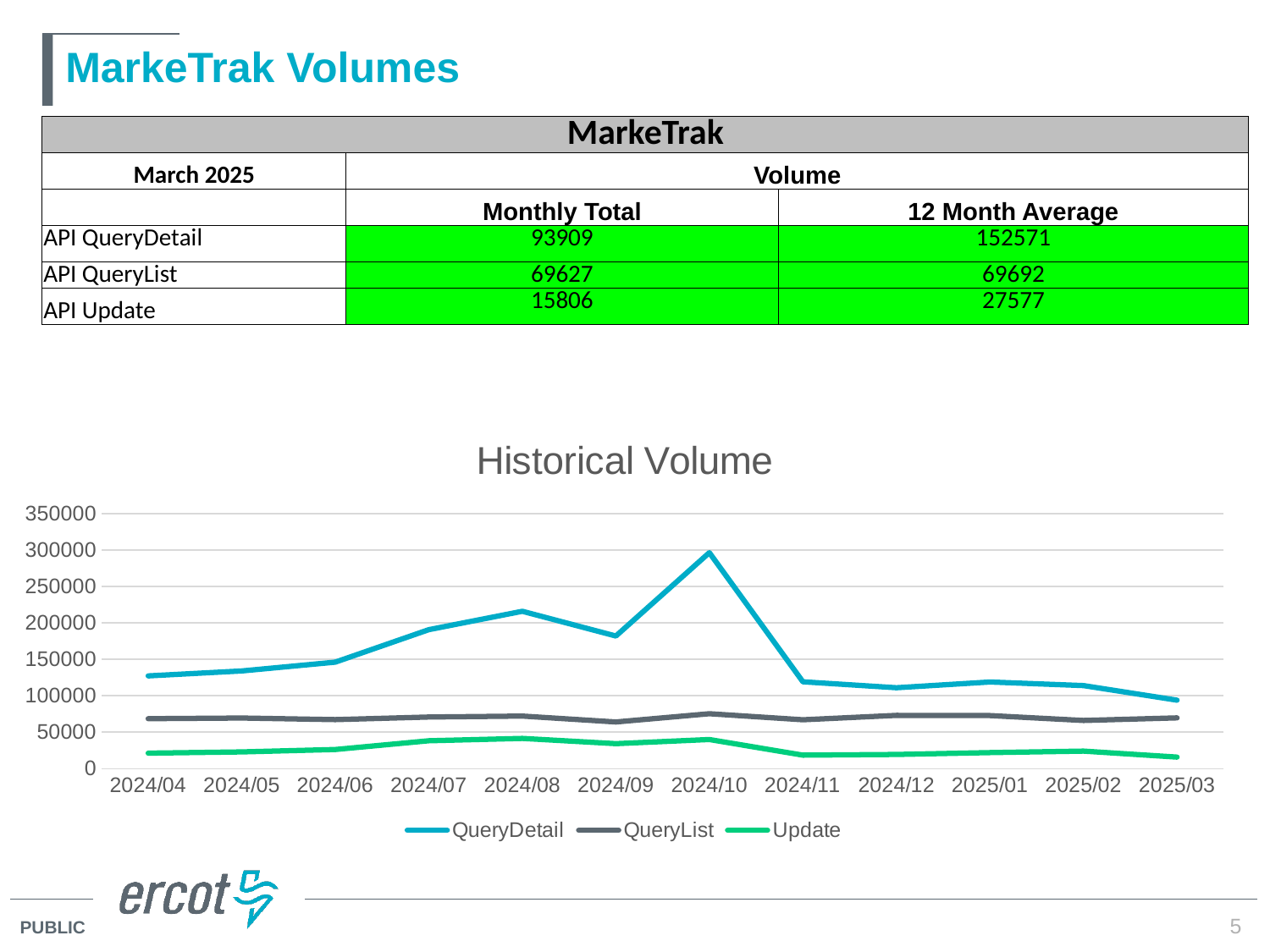
What is the title of the line chart on the slide? Historical Volume In the Historical Volume chart, which series has the larger value in 2024/10, QueryList or Update? QueryList In the Historical Volume chart, in which month does the QueryDetail series reach its highest value? 2024/10 In the Historical Volume chart, is the QueryDetail value for 2024/11 greater or less than 150000? less In the Historical Volume chart, is the QueryList value for 2024/04 greater or less than 50000? greater What kind of chart is the Historical Volume chart? line chart How many months are shown on the x axis of the Historical Volume chart? 12 In the Historical Volume chart, does the QueryDetail series rise or fall from 2024/10 to 2024/11? fall In the Historical Volume chart, in which month is the QueryDetail series at its lowest value? 2025/03 In the Historical Volume chart, is the QueryDetail value for 2024/10 greater or less than 250000? greater How many series does the legend of the Historical Volume chart list? 3 In the Historical Volume chart, which series has the larger value in 2024/08, QueryDetail or QueryList? QueryDetail